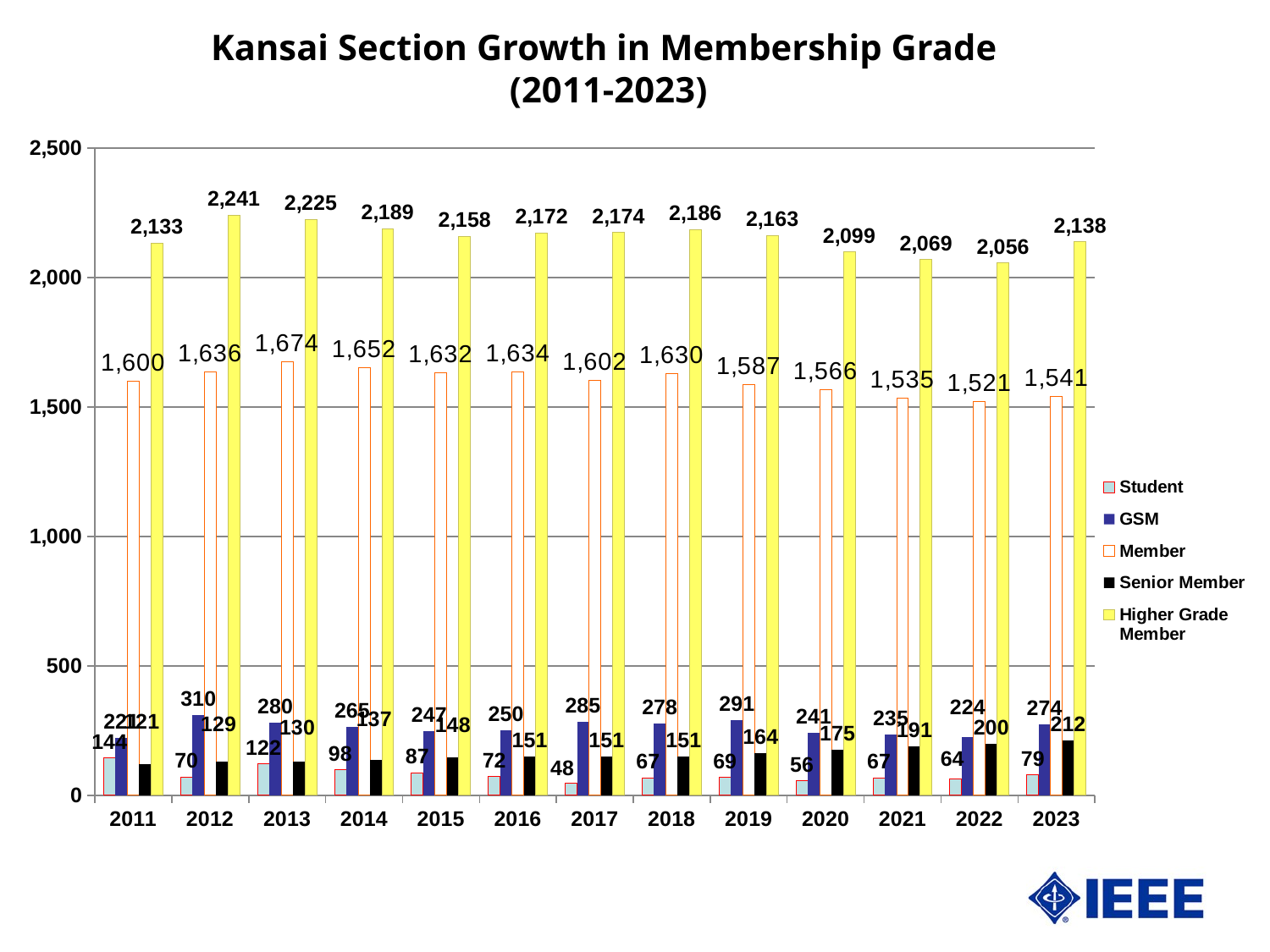
In which year is the Student value lowest? 2017 In which year is the GSM value highest? 2012 How many series does the legend list? 5 How many years are shown on the x axis? 13 Do the Senior Member values generally rise or fall from 2011 to 2023? Rise What kind of chart is shown on the slide? Bar chart What is the Higher Grade Member value for 2012? 2,241 What is the Senior Member value for 2023? 212 What is the Member value for 2013? 1,674 In which year is the Higher Grade Member value highest? 2012 Which is larger, the Student value for 2011 or for 2013? 2011 What is the difference between the Higher Grade Member values for 2012 and 2022? 185